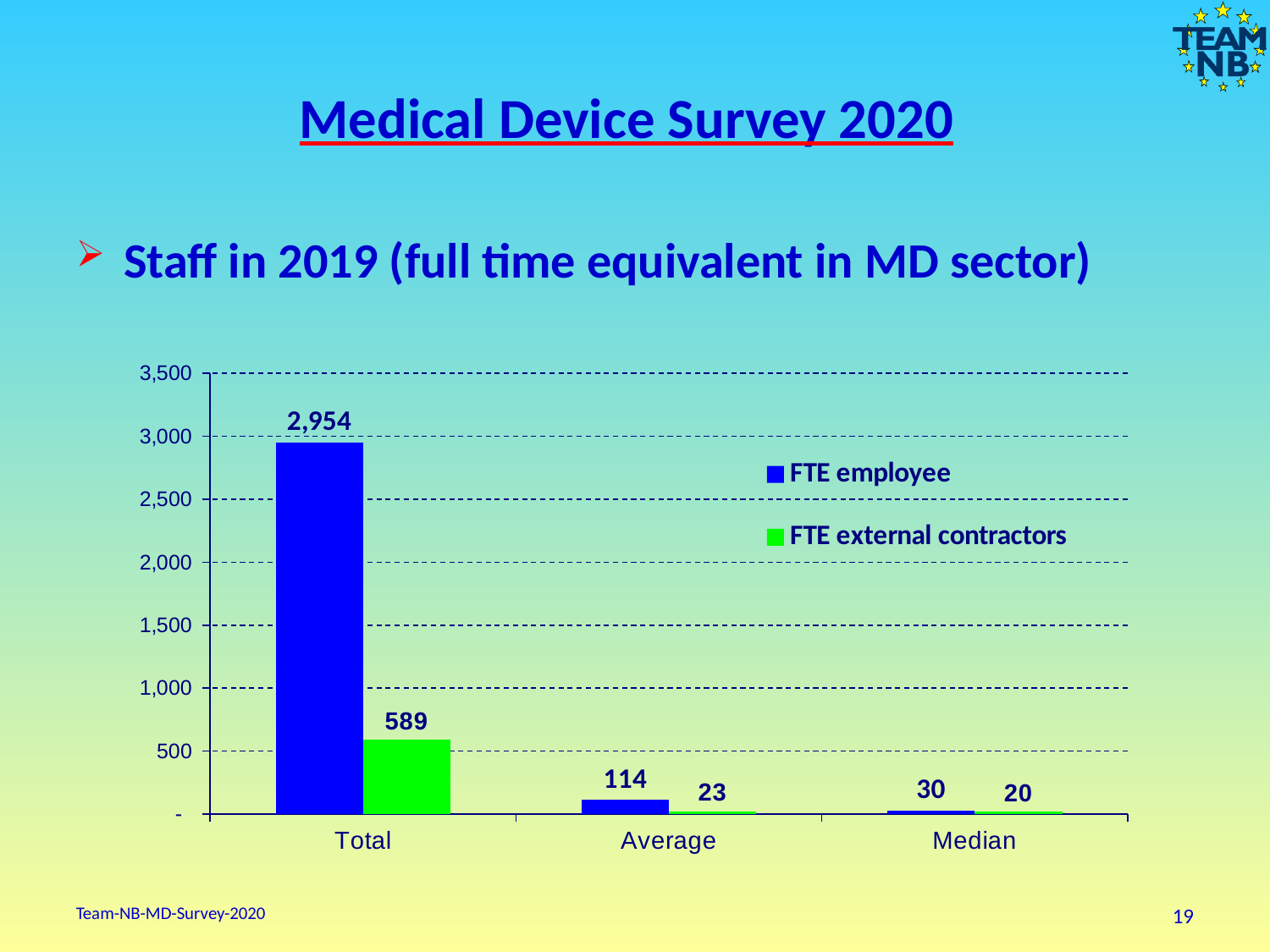
What is the FTE employee value for Average? 114 How many series does the legend list? 2 Which is larger for Median: FTE employee or FTE external contractors? FTE employee Which category has the highest FTE employee value? Total How many categories are shown on the x axis? 3 What is the difference between the FTE employee and FTE external contractors values for Total? 2,365 What is the FTE external contractors value for Total? 589 What is the difference between the FTE employee and FTE external contractors values for Average? 91 What is the FTE employee value for Total? 2,954 What is the FTE external contractors value for Median? 20 What kind of chart is shown on the slide? Bar chart Which category has the lowest FTE external contractors value? Median